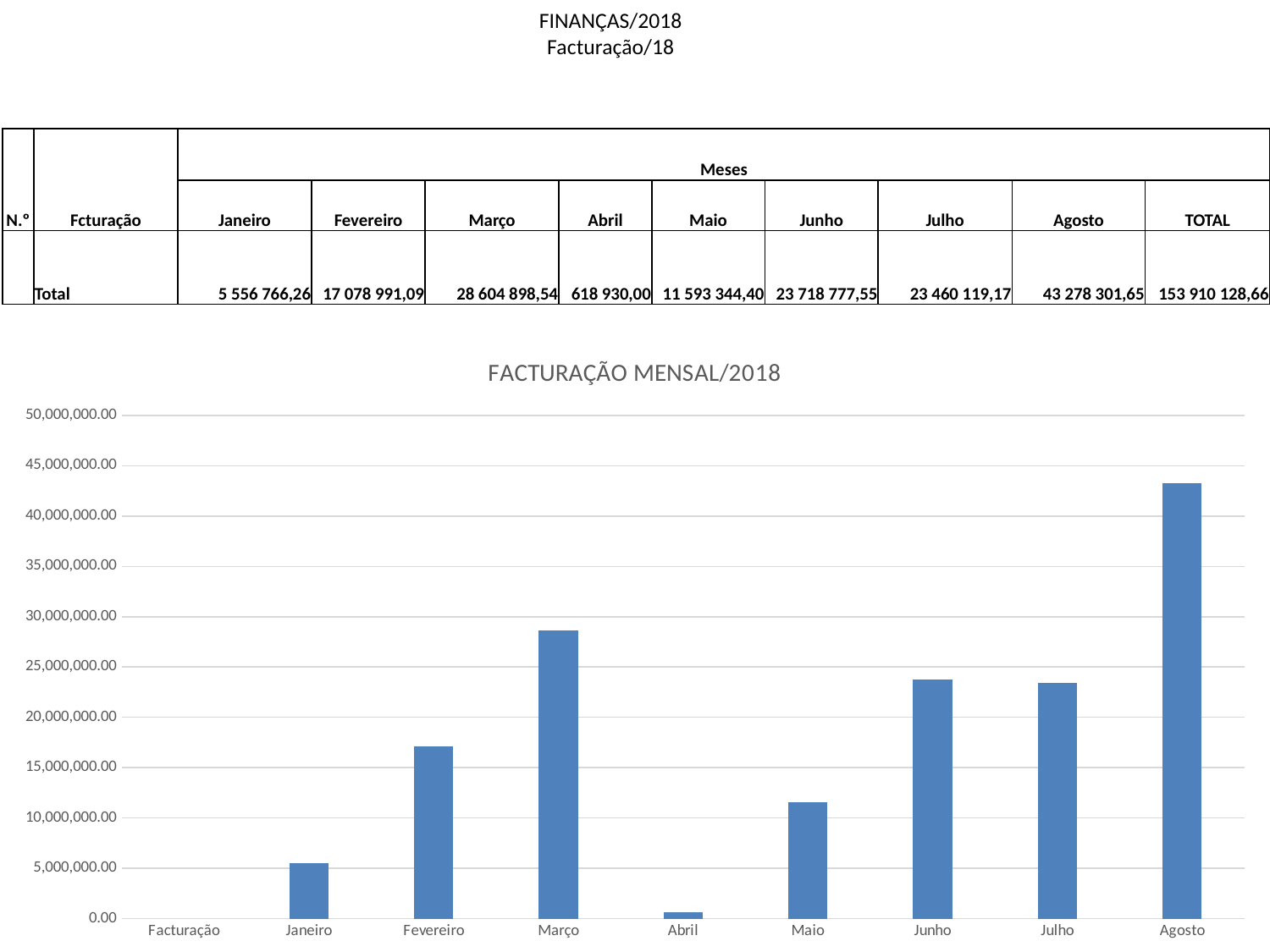
What type of chart is shown on the slide? bar chart According to the table, what is the TOTAL facturação for 2018? 153 910 128,66 What is the title of the chart? FACTURAÇÃO MENSAL/2018 Which month has the lowest bar in the chart? Abril Is the value for Março greater or less than 25,000,000.00? greater Using the table values, what is the difference between the facturação for Agosto and for Março? 14 673 403,11 Which is larger, the value for Março or the value for Fevereiro? Março Is the value for Agosto greater or less than 40,000,000.00? greater Which month has the highest bar in the chart? Agosto According to the table, what is the facturação value for Agosto? 43 278 301,65 Is the value for Abril greater or less than 5,000,000.00? less Which is larger, the value for Maio or the value for Junho? Junho